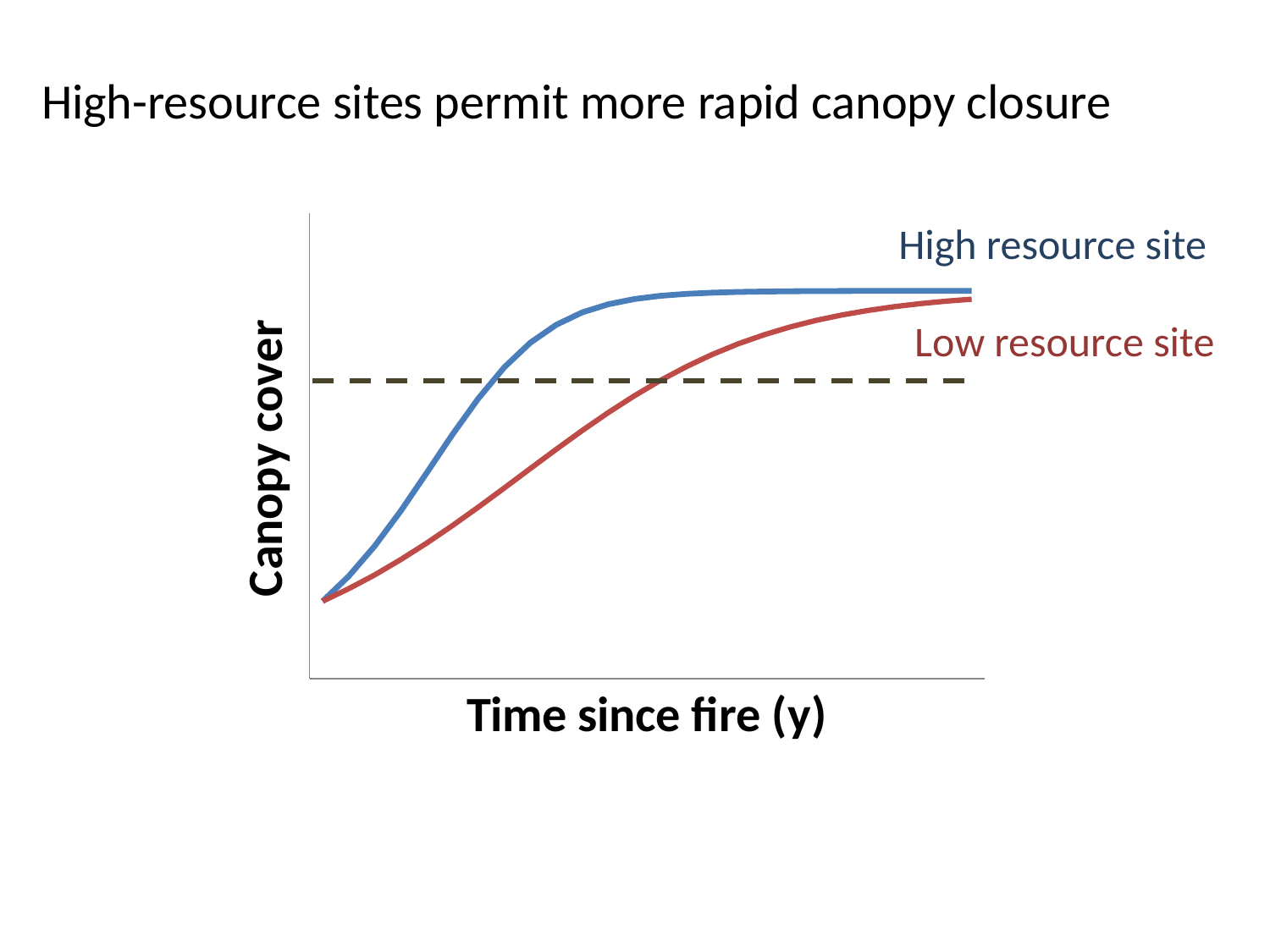
Does canopy cover rise or fall as time since fire increases? Rise How many series (curves) are plotted on the chart? 2 Do the two curves start at roughly the same canopy cover at time zero? Yes What is the label of the y axis? Canopy cover What is the label of the x axis? Time since fire (y) Which series is plotted in blue? High resource site Which series rises more steeply early after the fire? High resource site Which series has the lower canopy cover in the middle of the time range? Low resource site What kind of chart is shown on the slide? Line chart